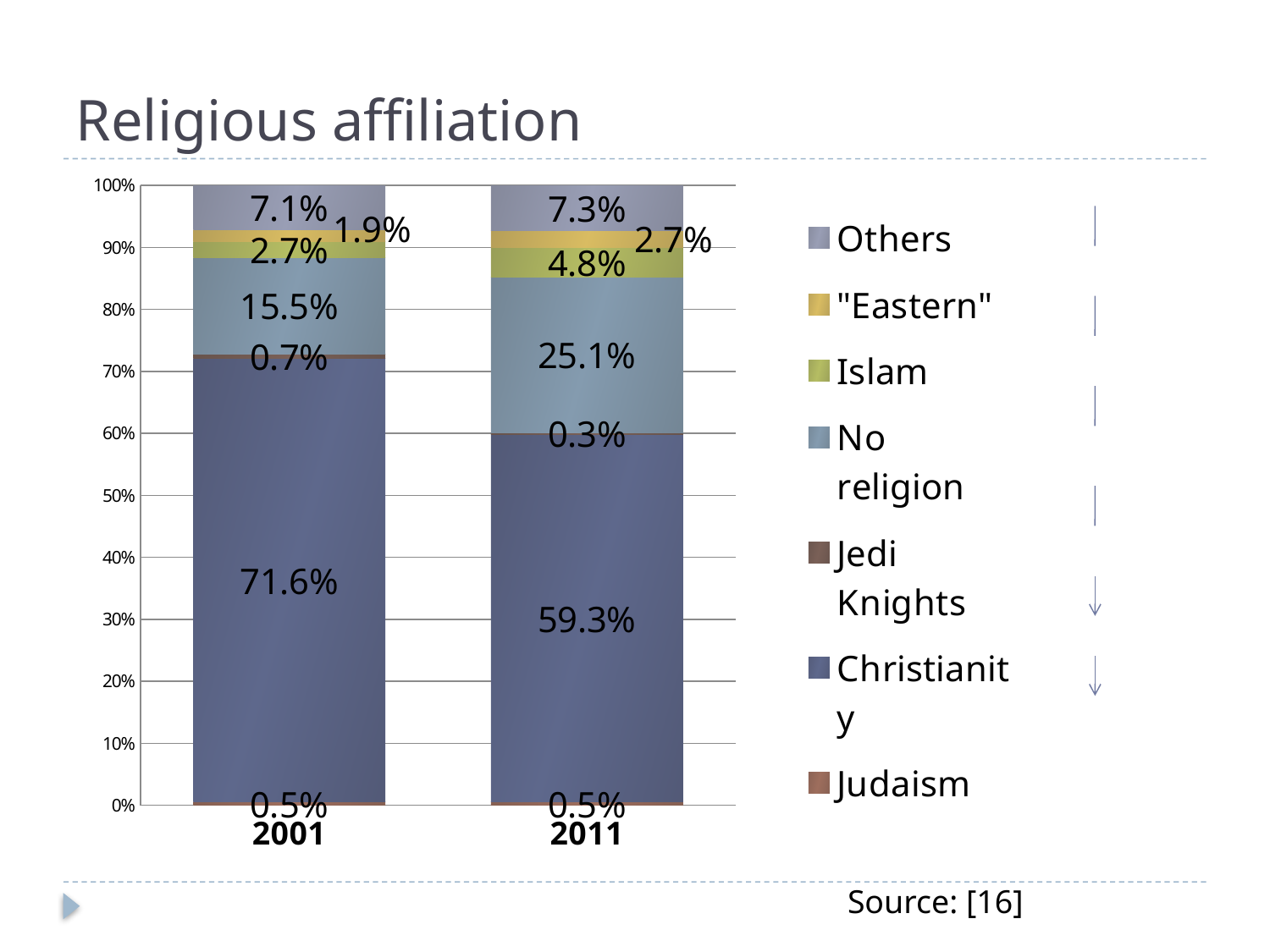
How many series does the legend list? 7 What is the value for No religion in 2011? 25.1% What is the value for Islam in 2001? 2.7% What is the value for Christianity in 2011? 59.3% How many bars (years) are shown on the x axis? 2 What is the value for Christianity in 2001? 71.6% By how many percentage points did the No religion share change from 2001 to 2011? 9.6 percentage points What is the title of the chart? Religious affiliation What type of chart is shown on the slide? Stacked bar chart Which is larger, the Christianity share in 2001 or in 2011? 2001 What is the value for Others in 2011? 7.3% Does the Christianity share rise or fall from 2001 to 2011? Fall